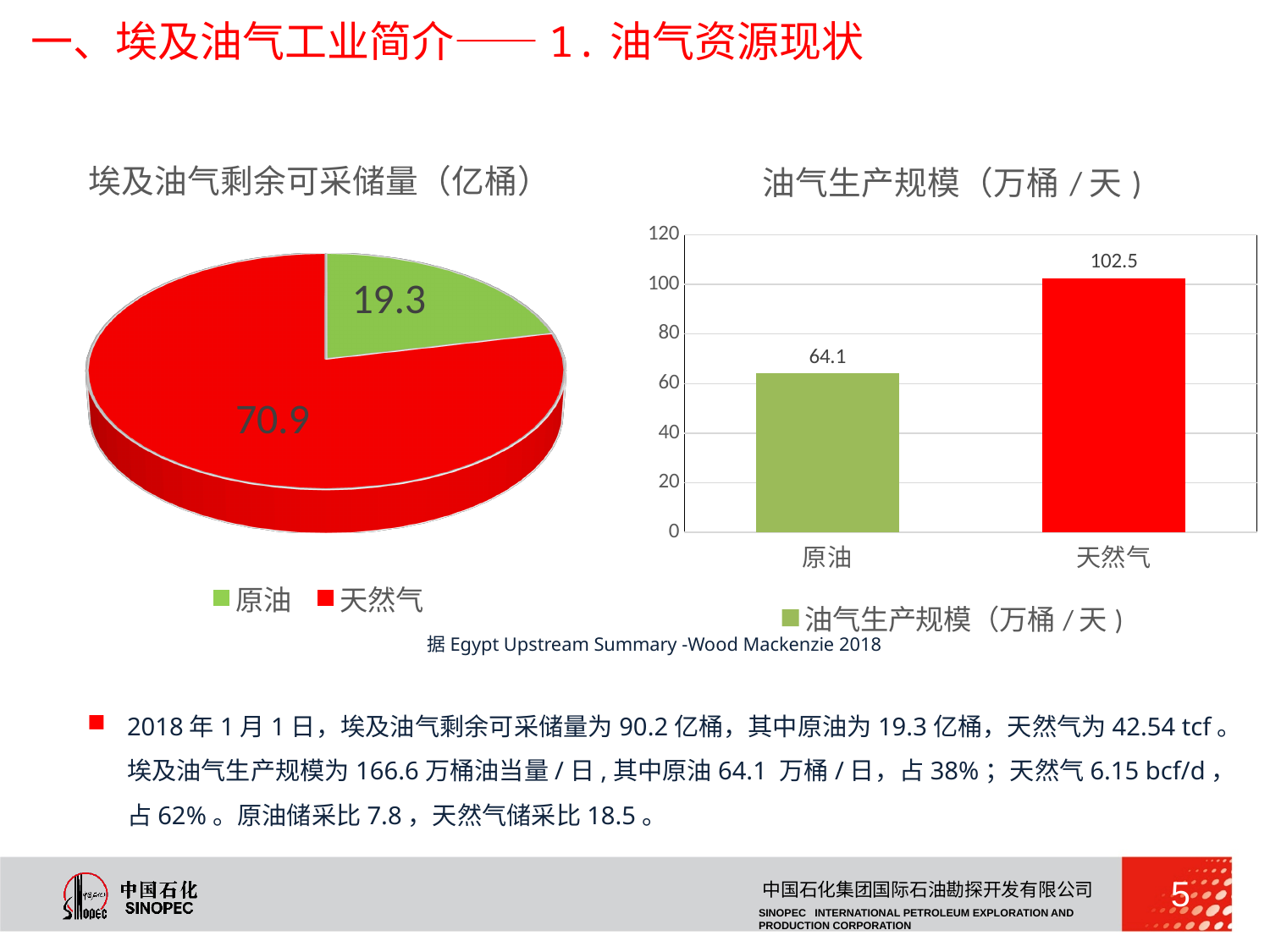
In the bar chart titled 油气生产规模（万桶/天）, what is the value for 天然气? 102.5 In the bar chart titled 油气生产规模（万桶/天）, which category has the highest value? 天然气 In the pie chart titled 埃及油气剩余可采储量（亿桶）, what is the value for 天然气? 70.9 In the pie chart titled 埃及油气剩余可采储量（亿桶）, what colour is the 原油 slice? Green In the bar chart titled 油气生产规模（万桶/天）, what is the value for 原油? 64.1 In the pie chart titled 埃及油气剩余可采储量（亿桶）, which slice is larger, 原油 or 天然气? 天然气 In the pie chart titled 埃及油气剩余可采储量（亿桶）, how many slices are there? 2 In the bar chart titled 油气生产规模（万桶/天）, what is the difference between the values for 天然气 and 原油? 38.4 In the pie chart titled 埃及油气剩余可采储量（亿桶）, what is the value for 原油? 19.3 In the pie chart titled 埃及油气剩余可采储量（亿桶）, what is the total of the two slices? 90.2 In the bar chart titled 油气生产规模（万桶/天）, is the value for 天然气 greater or less than 100? greater What kind of chart is the one on the right of the slide, titled 油气生产规模（万桶/天）? Bar chart